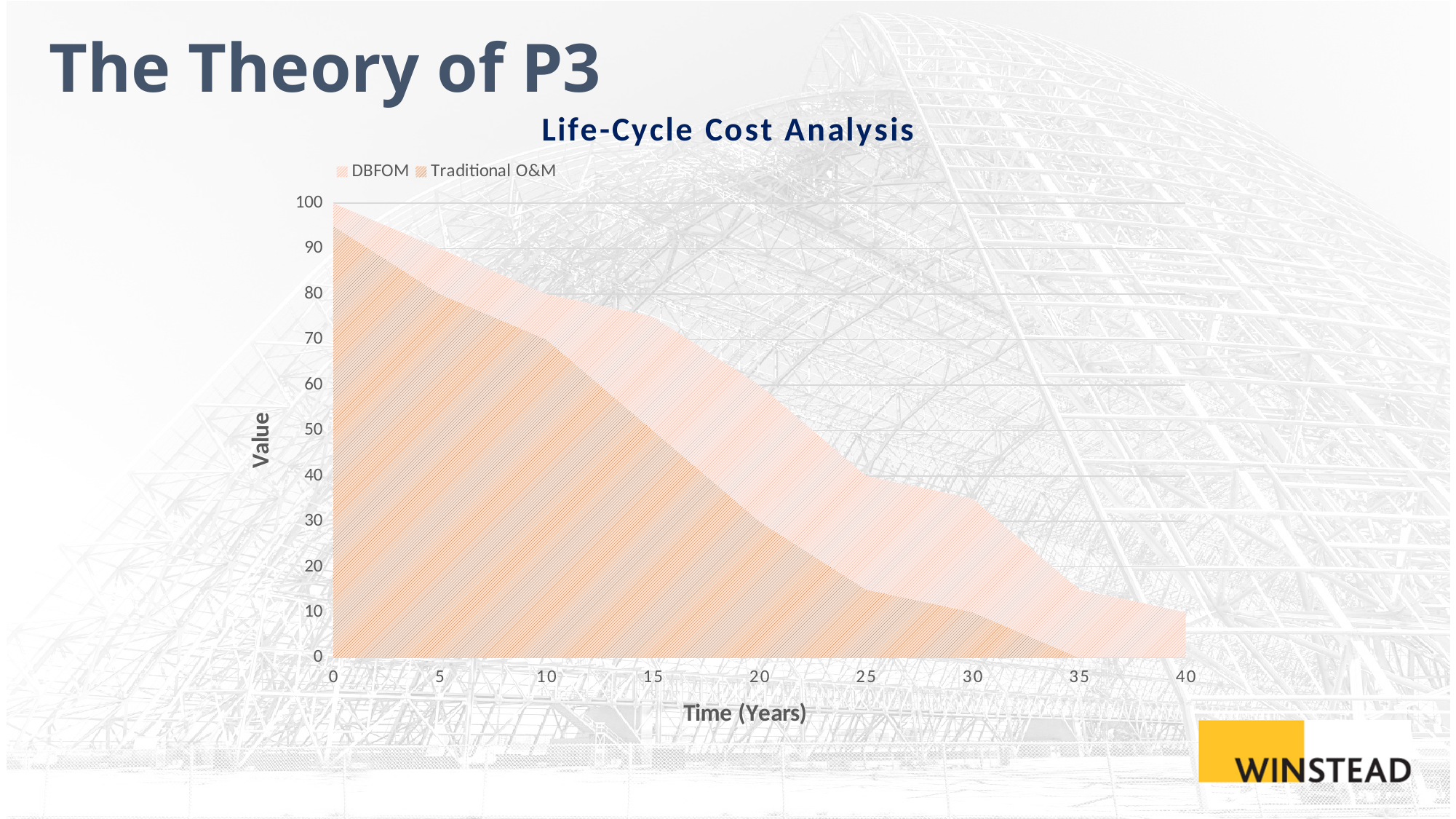
Is the value for DBFOM at year 30 greater or less than 20? greater At year 35, which series has the higher value, DBFOM or Traditional O&M? DBFOM Is the value for DBFOM at year 20 greater or less than 50? less How many series does the legend list? 2 Is the value for Traditional O&M at year 30 greater or less than 20? less What is the title of the chart? Life-Cycle Cost Analysis Do the values for Traditional O&M rise or fall as time increases along the x axis? fall What is the label of the x axis? Time (Years) What kind of chart is shown on the slide? area chart